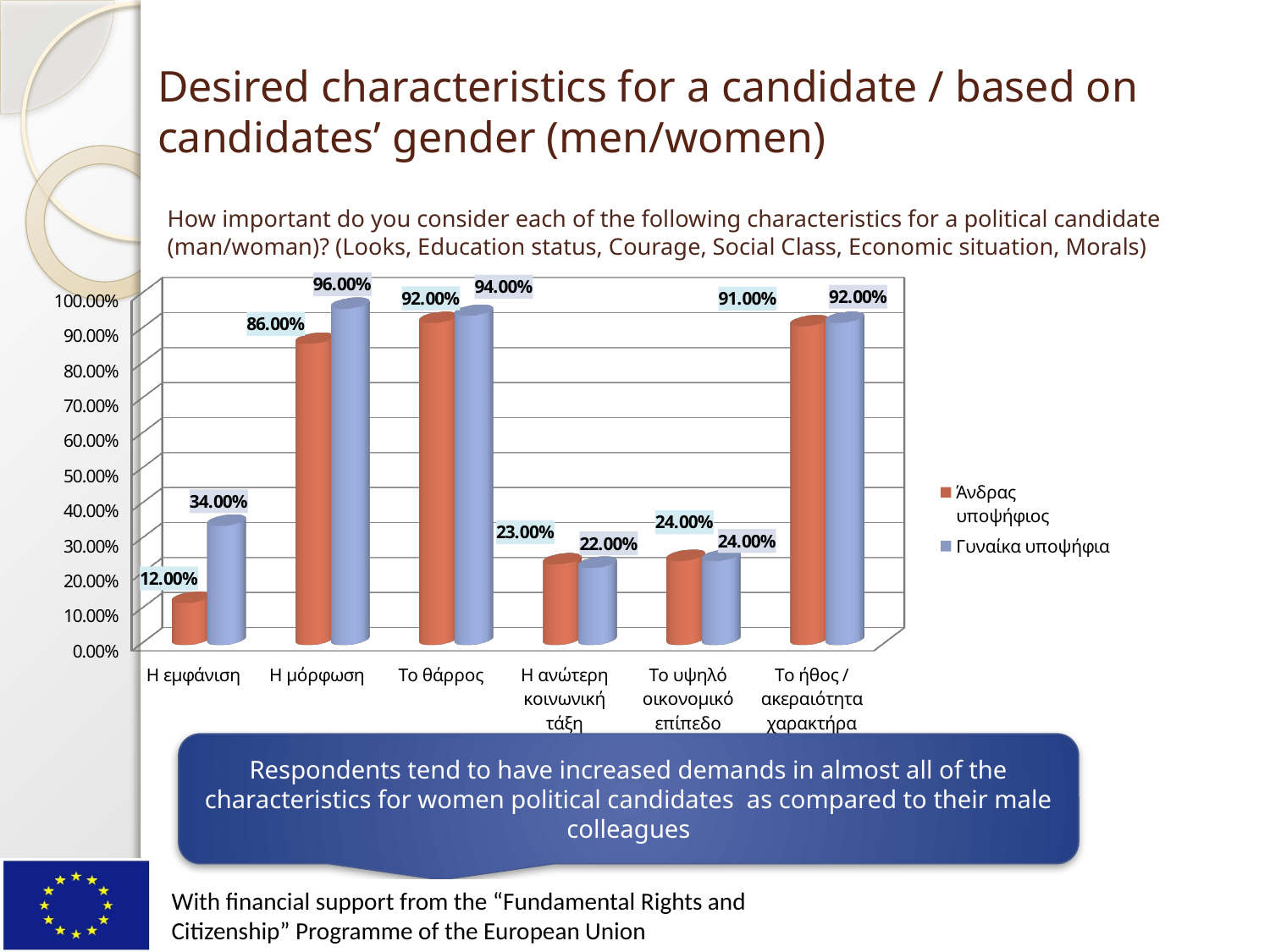
What is the value for Άνδρας υποψήφιος in the category Το ήθος / ακεραιότητα χαρακτήρα? 91.00% What kind of chart is shown on the slide? Bar chart What is the value for Άνδρας υποψήφιος in the category Η εμφάνιση? 12.00% For Η ανώτερη κοινωνική τάξη, which series has the larger value, Άνδρας υποψήφιος or Γυναίκα υποψήφια? Άνδρας υποψήφιος What is the value for Γυναίκα υποψήφια in the category Η μόρφωση? 96.00% Which category has the highest value for the Γυναίκα υποψήφια series? Η μόρφωση Is the value for Άνδρας υποψήφιος in Το θάρρος greater or less than 80.00%? greater Which category has the lowest value for the Άνδρας υποψήφιος series? Η εμφάνιση What is the difference between the Γυναίκα υποψήφια and Άνδρας υποψήφιος values for Η μόρφωση? 10.00% How many series does the chart's legend list? 2 What is the difference between the Γυναίκα υποψήφια and Άνδρας υποψήφιος values for Η εμφάνιση? 22.00% How many categories are shown on the x axis of the chart? 6